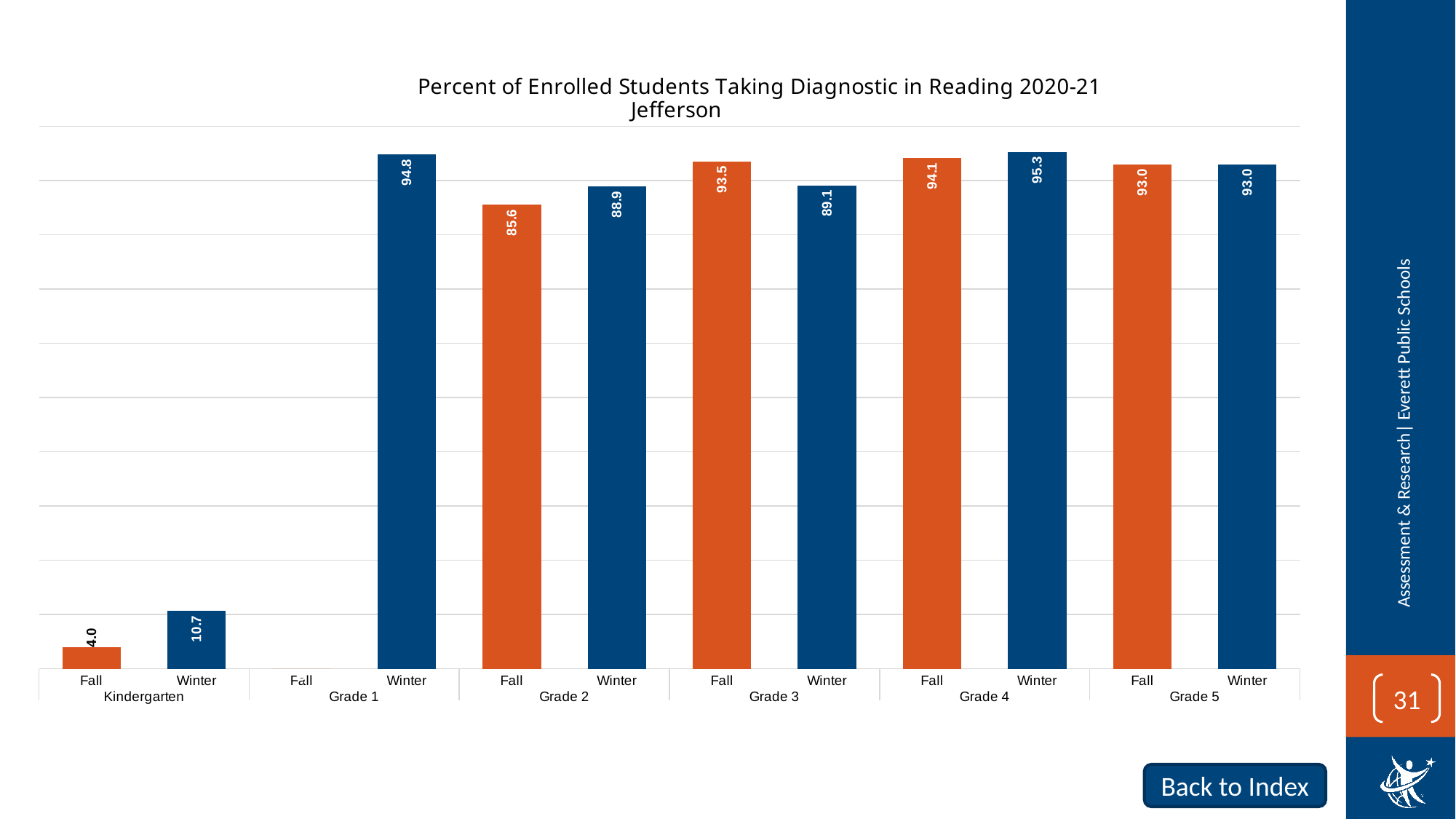
What is the difference between the Winter and Fall values for Grade 2? 3.3 What is the Fall value for Kindergarten? 4.0 What is the Fall value for Grade 3? 93.5 Which grade has the highest Winter value? Grade 4 Which grade has the lowest Winter value? Kindergarten Which school is named in the chart title? Jefferson What is the difference between the Fall and Winter values for Grade 3? 4.4 What is the Winter value for Grade 1? 94.8 What kind of chart is shown on the slide? Bar chart For Grade 3, which is larger, the Fall value or the Winter value? Fall What is the Winter value for Grade 5? 93.0 How many grade levels are shown on the x axis? 6